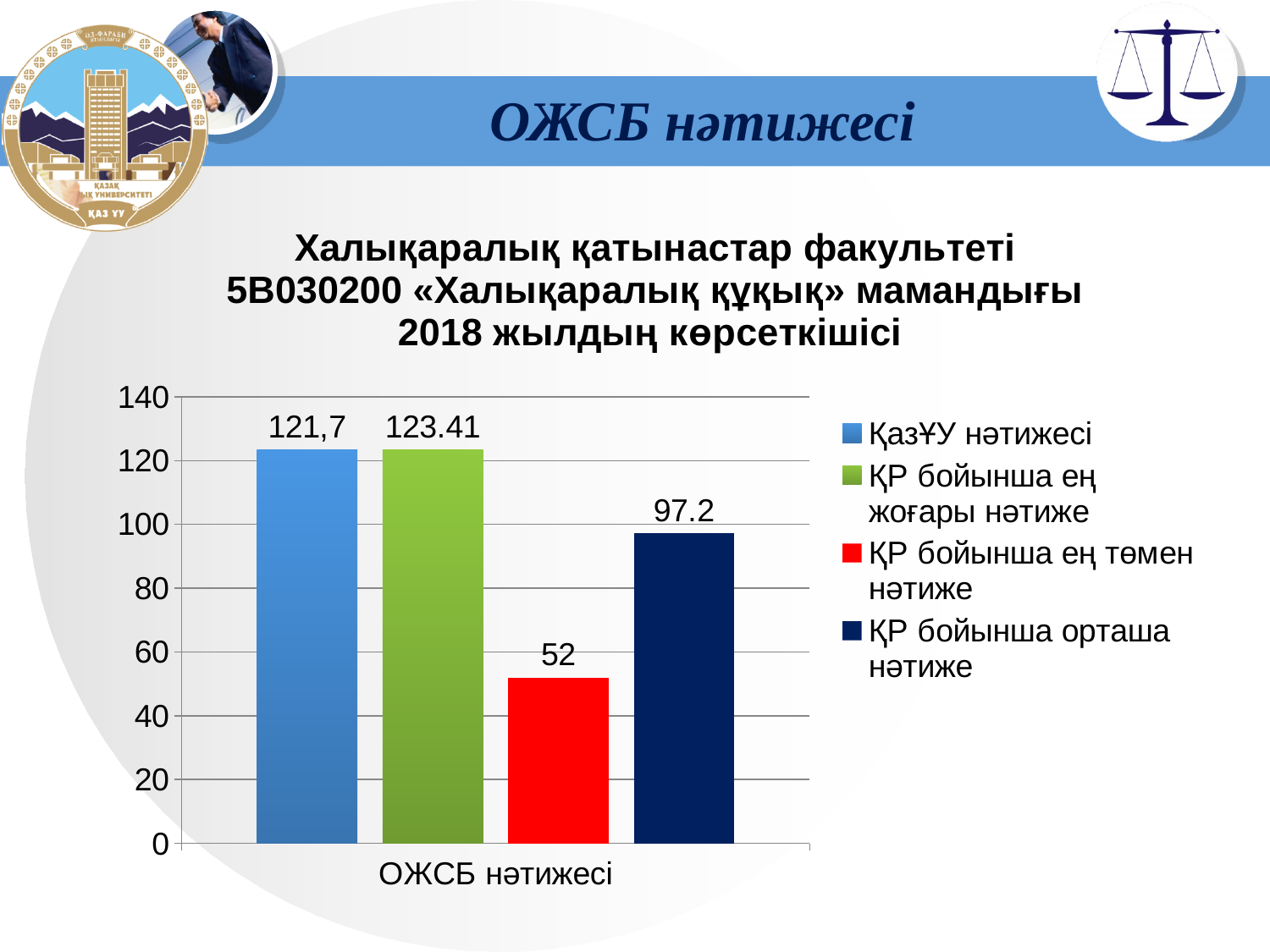
Which series has the lowest value? ҚР бойынша ең төмен нәтиже What is the value for ҚР бойынша ең төмен нәтиже? 52 What colour is the bar for ҚР бойынша ең төмен нәтиже? red Which is larger, ҚазҰУ нәтижесі or ҚР бойынша орташа нәтиже? ҚазҰУ нәтижесі What is the value for ҚР бойынша орташа нәтиже? 97.2 What is the value for ҚазҰУ нәтижесі? 121,7 What is the value for ҚР бойынша ең жоғары нәтиже? 123.41 What is the difference between ҚР бойынша ең жоғары нәтиже and ҚР бойынша ең төмен нәтиже? 71.41 What kind of chart is shown on the slide? bar chart What is the difference between ҚР бойынша орташа нәтиже and ҚР бойынша ең төмен нәтиже? 45.2 How many series does the legend list? 4 Is the value for ҚР бойынша орташа нәтиже greater or less than 100? less